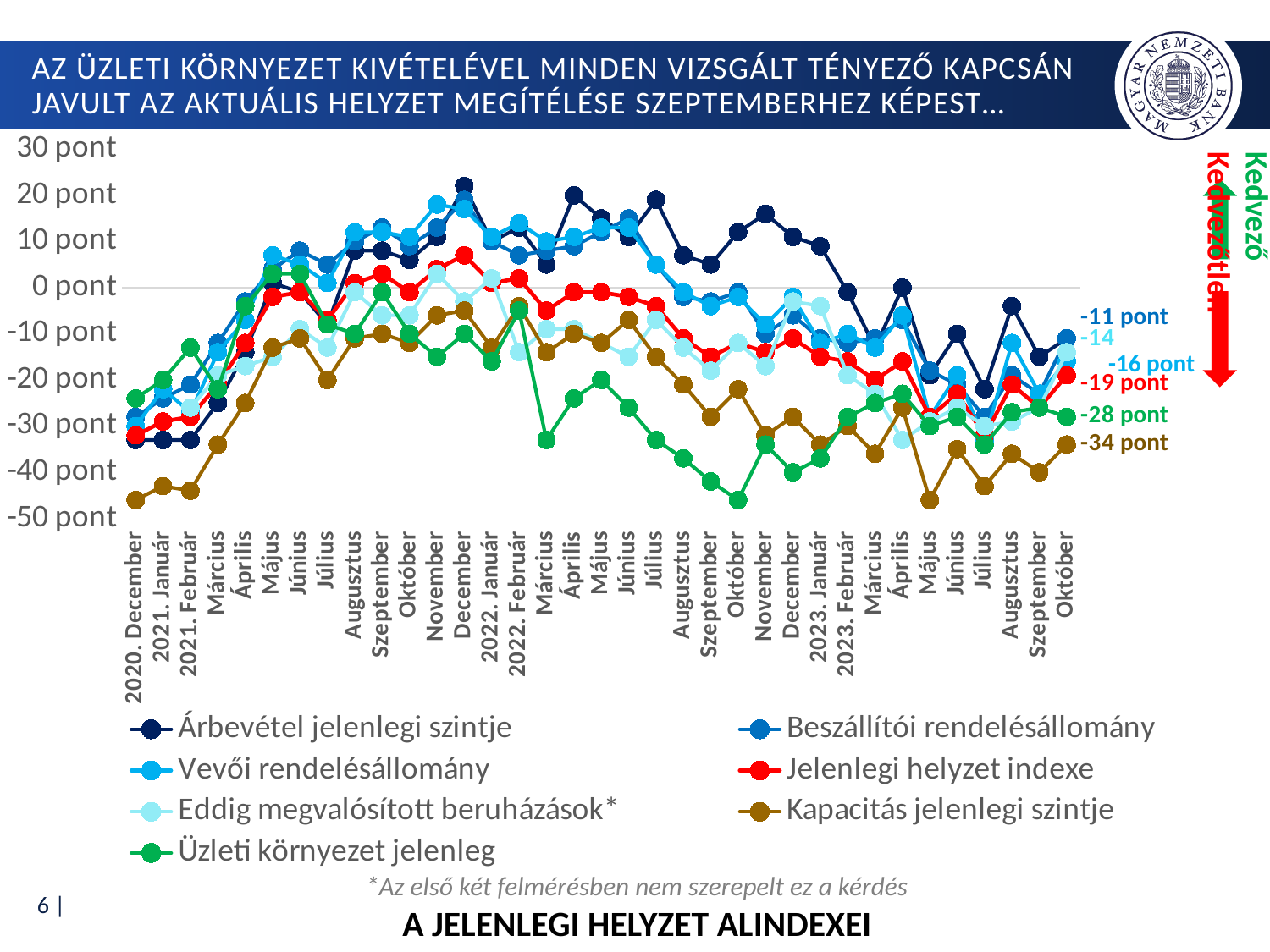
How many series does the legend list? 7 Does Kapacitás jelenlegi szintje rise or fall from 2020. December to 2021 Május? rise Which series has the lowest value at the last point (Október 2023)? Kapacitás jelenlegi szintje What is the difference between Jelenlegi helyzet indexe and Kapacitás jelenlegi szintje at the last point (Október 2023)? 15 pont What kind of chart is shown on the slide? line chart Is the value for Kapacitás jelenlegi szintje in 2020. December greater or less than -40 pont? less Is the value for Üzleti környezet jelenleg in 2022 Október greater or less than -40 pont? less At the last point (Október 2023), which is higher: Üzleti környezet jelenleg or Kapacitás jelenlegi szintje? Üzleti környezet jelenleg What is the value of Jelenlegi helyzet indexe at the last point (Október 2023)? -19 pont What is the value of Üzleti környezet jelenleg at the last point (Október 2023)? -28 pont What is the title of the chart at the bottom of the slide? A JELENLEGI HELYZET ALINDEXEI What is the value of Kapacitás jelenlegi szintje at the last point (Október 2023)? -34 pont